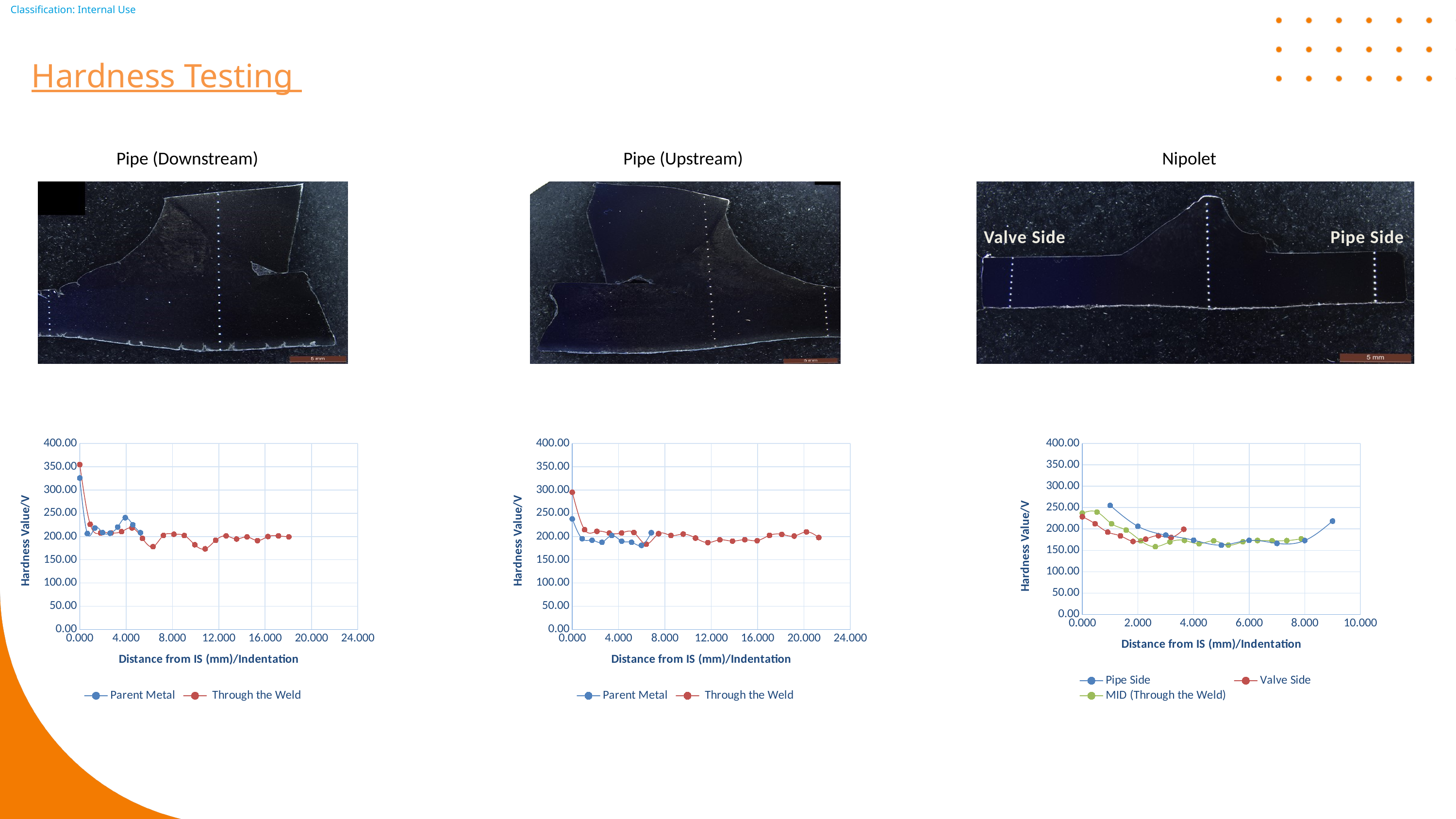
How many series does the legend of the Nipolet chart list? 3 In the Pipe (Downstream) chart, is the Parent Metal value at 0.000 mm greater or less than 300.00? greater What is the x-axis title of the Pipe (Upstream) chart? Distance from IS (mm)/Indentation In the Pipe (Upstream) chart, do the Through the Weld values generally rise or fall over the first few millimetres from 0.000 mm? fall In the Nipolet chart, is the Valve Side value at 0.000 mm greater or less than 250.00? less In the Pipe (Upstream) chart, which series has the higher value at 0.000 mm, Parent Metal or Through the Weld? Through the Weld What kind of chart is the Pipe (Downstream) chart? line chart In the Pipe (Downstream) chart, is the Through the Weld value at 0.000 mm greater or less than 300.00? greater How many series does the legend of the Pipe (Downstream) chart list? 2 In the Pipe (Downstream) chart, which series has the higher value at 0.000 mm, Parent Metal or Through the Weld? Through the Weld What is the y-axis title of the Nipolet chart? Hardness Value/V